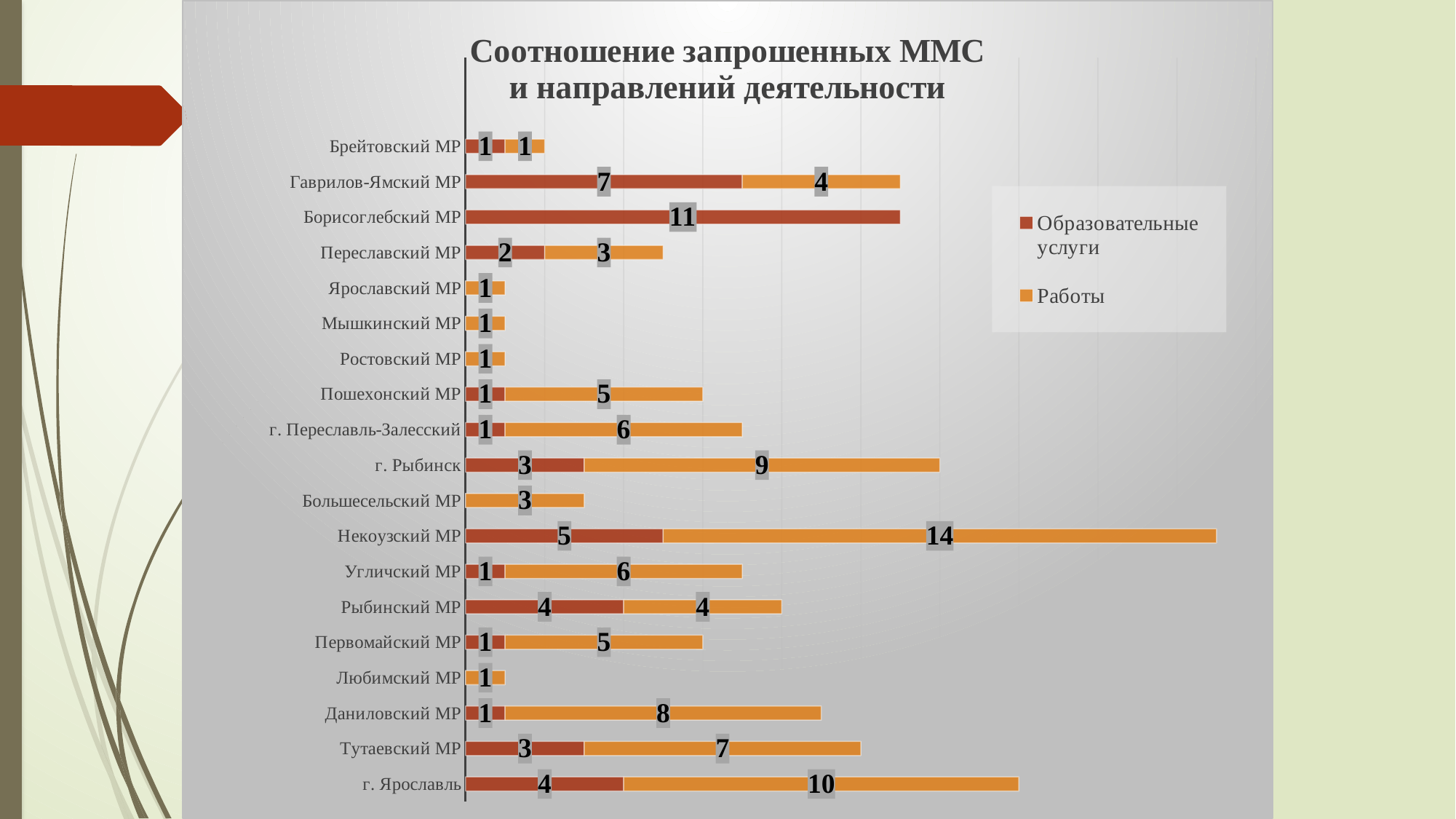
What is the value of Работы for г. Ярославль? 10 How many series does the legend list? 2 Which has a larger value for Работы: Даниловский МР or Тутаевский МР? Даниловский МР What is the value of Образовательные услуги for Гаврилов-Ямский МР? 7 What is the value of Образовательные услуги for Борисоглебский МР? 11 For г. Рыбинск, what is the difference between Работы and Образовательные услуги? 6 How many categories are shown on the chart? 19 What is the value of Работы for Некоузский МР? 14 What is the total of the stacked bar for Некоузский МР? 19 Which category has the highest value for Образовательные услуги? Борисоглебский МР Which category has the highest value for Работы? Некоузский МР What is the total of the stacked bar for г. Ярославль? 14